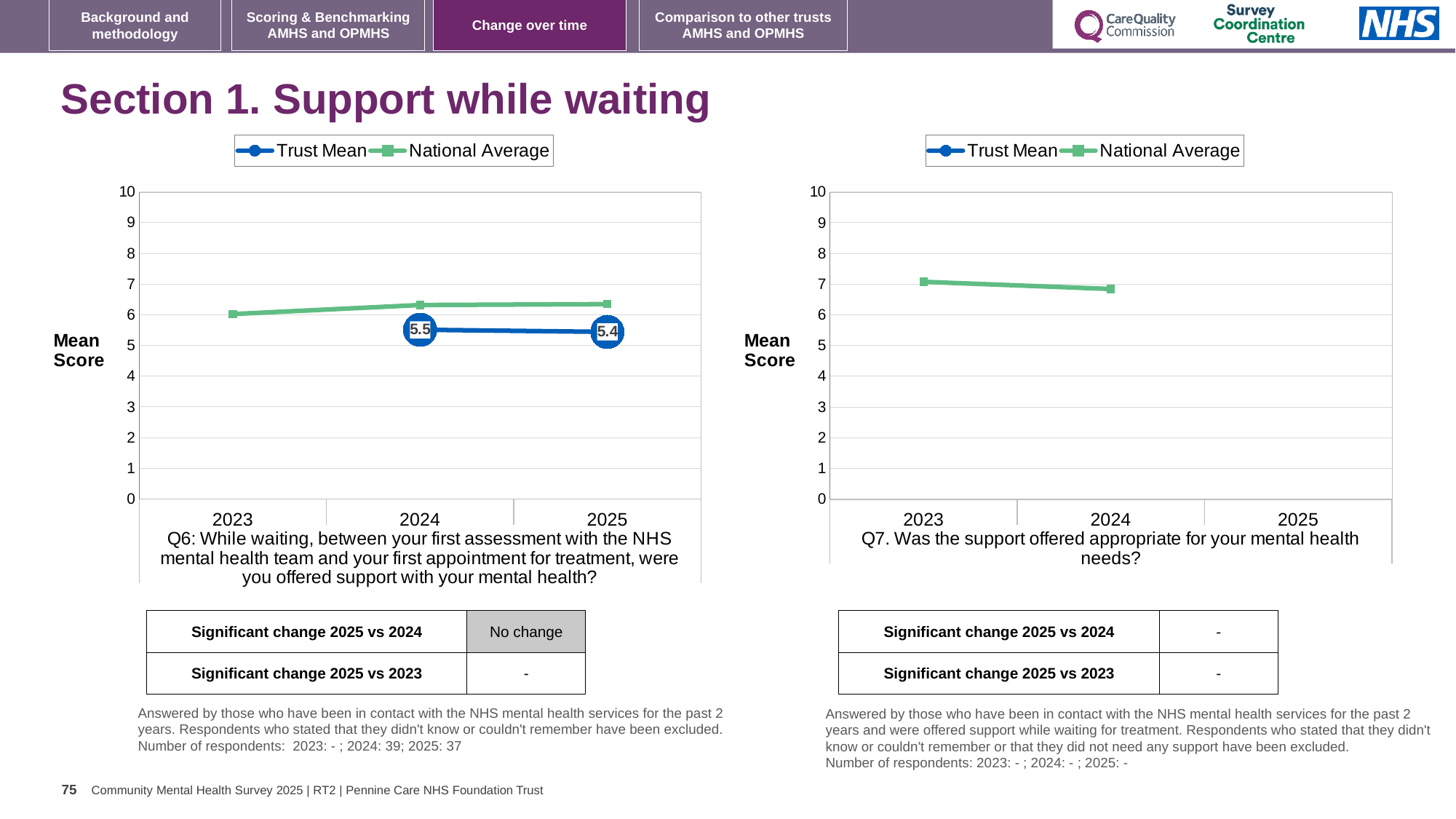
In the left chart (Q6), what is the Trust Mean score for 2025? 5.4 In the left chart (Q6), which year has the higher Trust Mean score, 2024 or 2025? 2024 How many years are shown on the x axis of the left chart (Q6)? 3 In the left chart (Q6), which is larger in 2025, the Trust Mean or the National Average? National Average In the right chart (Q7), does the National Average rise or fall from 2023 to 2024? fall In the left chart (Q6), what is the difference between the Trust Mean scores for 2024 and 2025? 0.1 In the left chart (Q6), what is the Trust Mean score for 2024? 5.5 How many series does the legend of the left chart (Q6) list? 2 What are the two legend entries shown above the right chart (Q7)? Trust Mean and National Average In the left chart (Q6), is the National Average value for 2023 greater or less than 5? greater In the right chart (Q7), is the National Average value for 2023 greater or less than 6? greater What kind of chart is the left chart (Q6)? Line chart